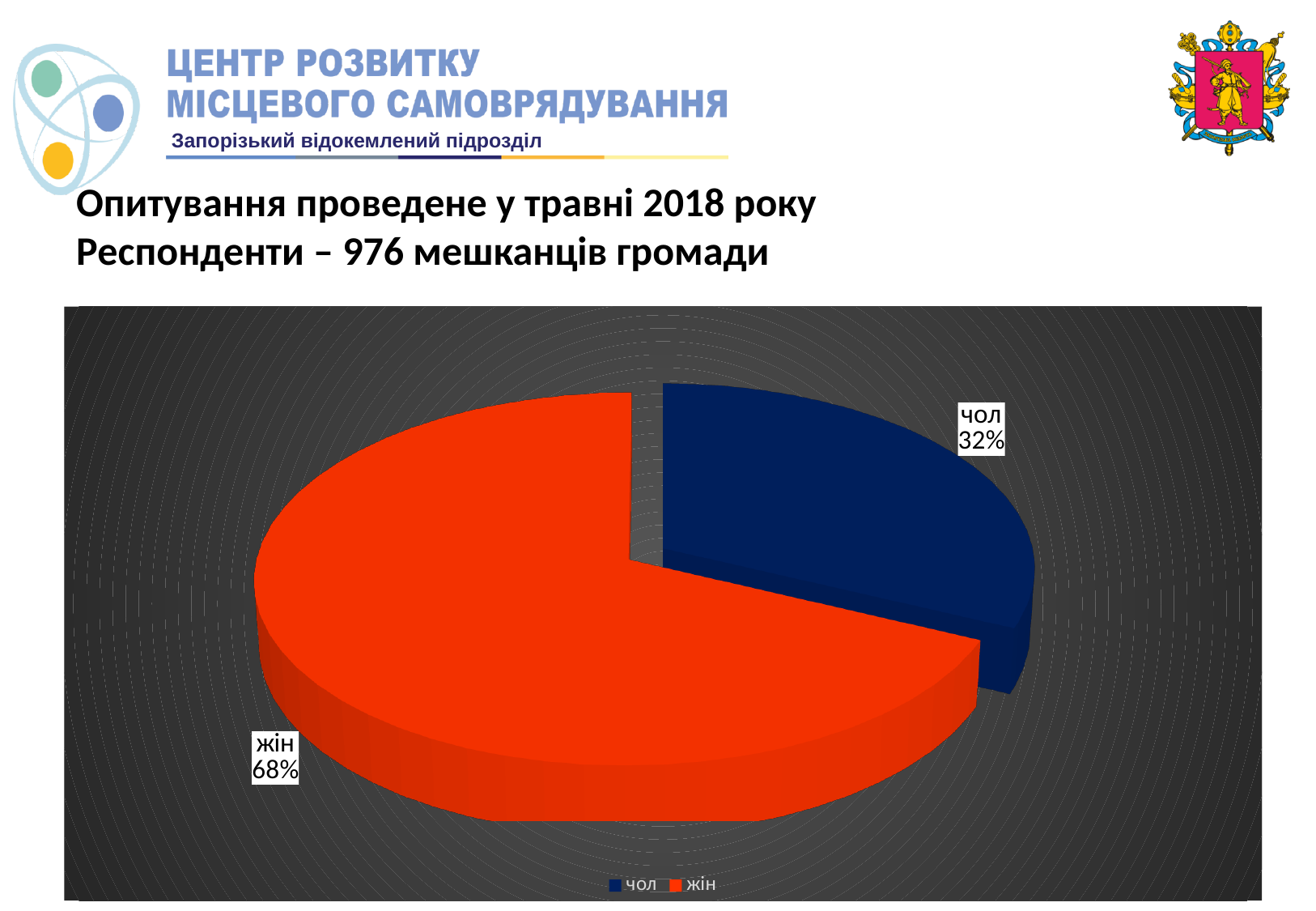
What is the difference in percentage points between the "жін" and "чол" slices? 36 Which is larger, the "чол" slice or the "жін" slice? жін What colour is the "жін" slice? red Which slice of the pie is the largest? жін Which slice of the pie is the smallest? чол What share of the pie does the "жін" slice represent? 68% What kind of chart is shown on the slide? pie chart What share of the pie does the "чол" slice represent? 32% How many slices does the pie chart have? 2 How many entries does the legend list? 2 What colour is the "чол" slice? dark blue